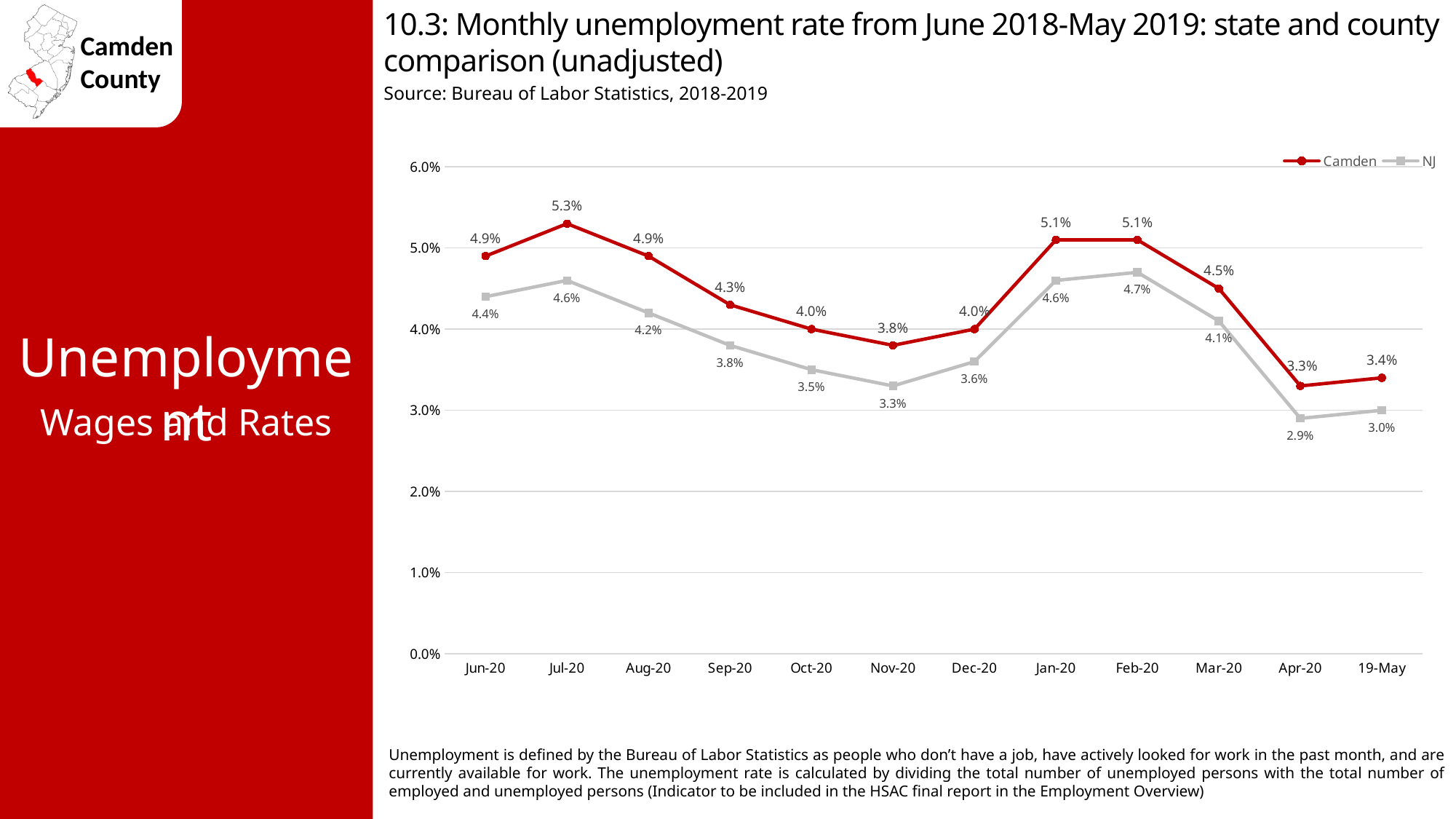
In which month is the Camden unemployment rate highest? Jul-20 What type of chart is shown on the slide? line chart Does the Camden unemployment rate rise or fall from Jul-20 to Nov-20? fall In which month is the NJ unemployment rate lowest? Apr-20 What is the Camden unemployment rate for Mar-20? 4.5% Which series has the higher value in Feb-20, Camden or NJ? Camden How many months are plotted on the x axis? 12 How many series does the legend list? 2 What is the Camden unemployment rate for Jul-20? 5.3% What is the difference between the Camden and NJ unemployment rates in Jan-20? 0.5% Which series is drawn in red? Camden What is the NJ unemployment rate for Nov-20? 3.3%